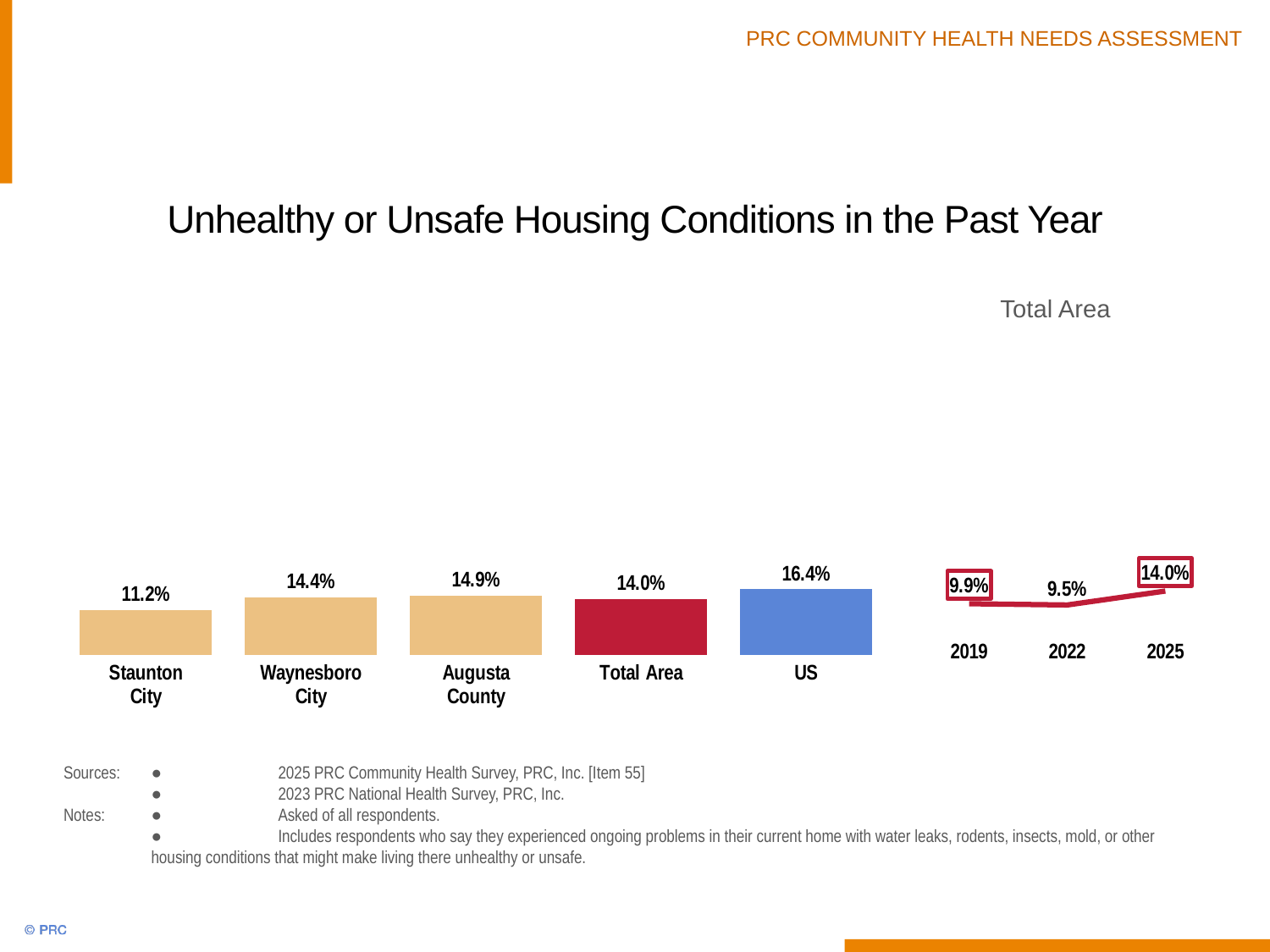
In the bar chart, what is the difference between the US value and the Total Area value? 2.4% In the Total Area line chart, what is the difference between the 2025 value and the 2019 value? 4.1% In the Total Area line chart, do values rise or fall from 2022 to 2025? Rise How many categories does the bar chart show? 5 In the Total Area line chart, what is the value for 2025? 14.0% In the bar chart, which category has the lowest value? Staunton City In the bar chart, which is larger, the value for Waynesboro City or the value for Augusta County? Augusta County In the bar chart, what is the value for Staunton City? 11.2% In the bar chart, what is the value for Augusta County? 14.9% In the Total Area line chart, what is the value for 2022? 9.5% In the bar chart, which category has the highest value? US What kind of chart is the chart on the left of the slide? Bar chart